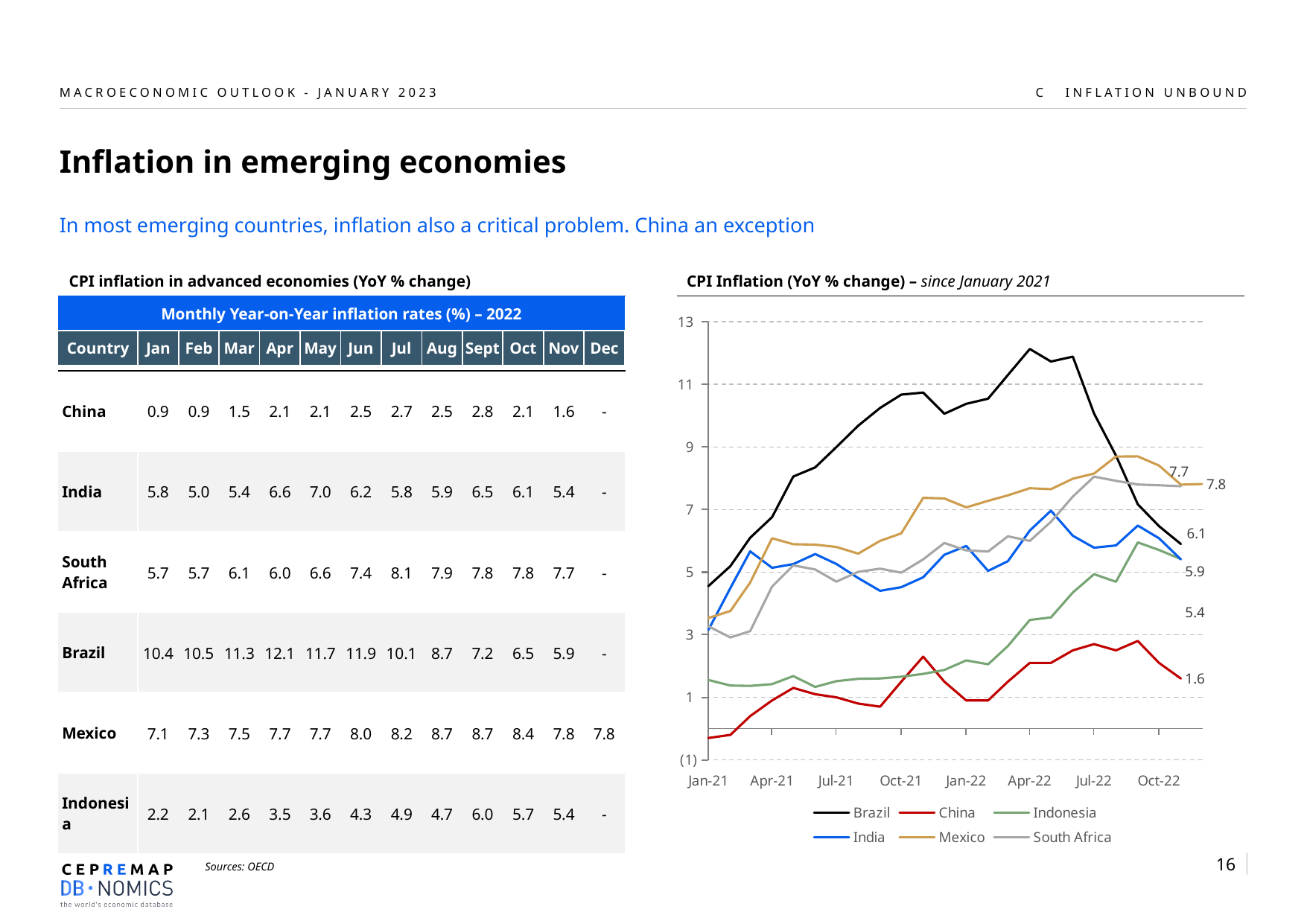
In the CPI Inflation chart, does Indonesia's line rise or fall between Jan-22 and Jul-22? rise In the CPI Inflation chart, is Indonesia's value at Jan-21 greater or less than 3? less In the CPI Inflation chart, is Brazil's value at Apr-22 greater or less than 11? greater In the CPI Inflation chart, what is the data label at the end of the China line? 1.6 In the CPI Inflation chart, which country's line is the lowest throughout the period? China In the CPI Inflation chart, which is larger at Apr-22, Brazil or China? Brazil What kind of chart is shown on the right side of the slide? line chart In the CPI Inflation chart, does Brazil's line rise or fall between Apr-22 and Oct-22? fall In the CPI Inflation chart, is China's value at Jan-21 greater or less than 1? less In the CPI Inflation chart, which country's line reaches the highest value over the period? Brazil How many series does the legend of the CPI Inflation chart list? 6 What colour is the Brazil line in the CPI Inflation chart? black